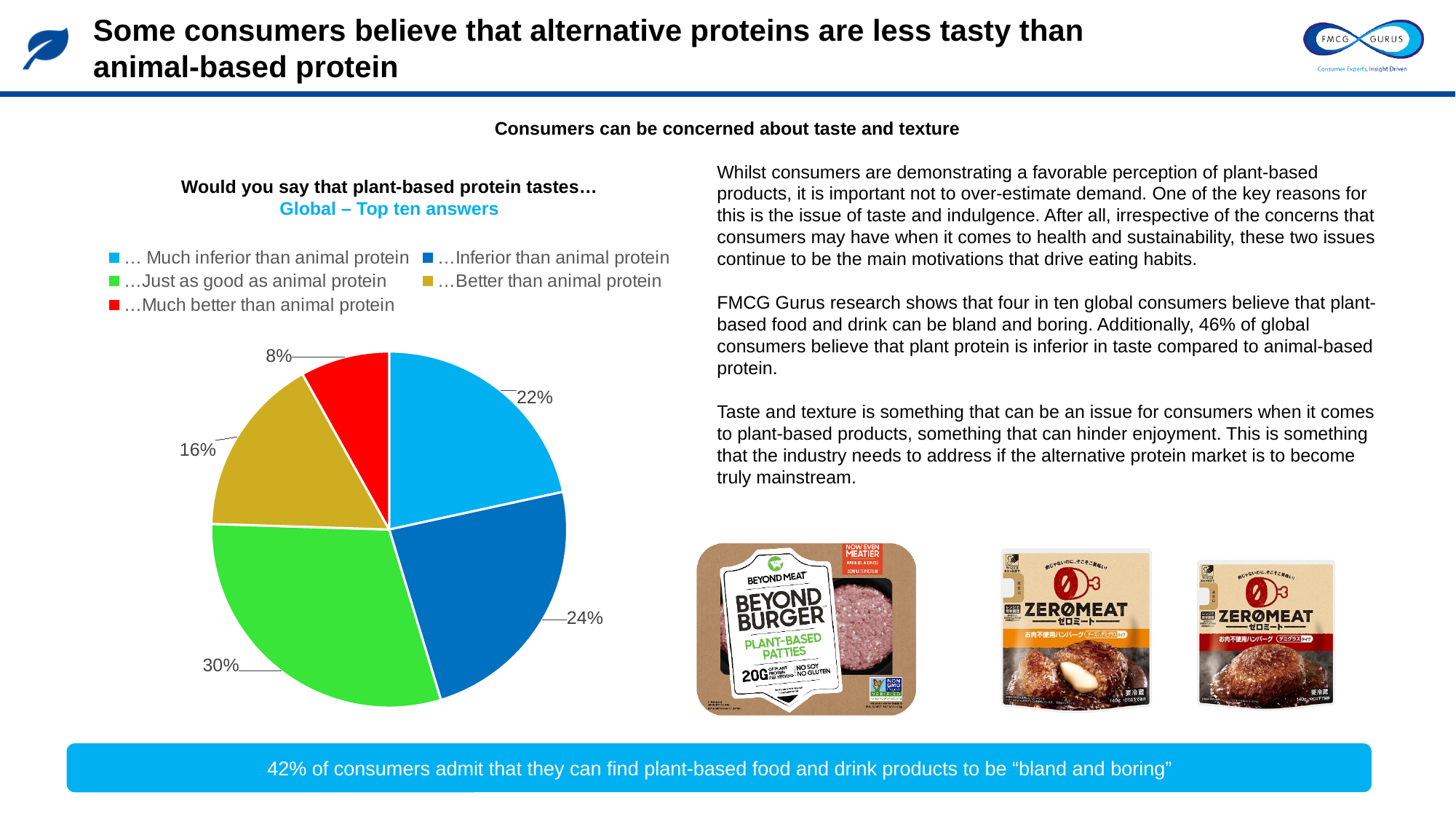
How many slices does the pie chart have? 5 What colour is the slice for '…Much better than animal protein'? Red What share of the pie is for '…Much better than animal protein'? 8% What is the difference between the shares for '…Just as good as animal protein' and '…Much better than animal protein'? 22% What kind of chart is shown on the slide? Pie chart What share of the pie is for '… Much inferior than animal protein'? 22% What share of the pie is for '…Just as good as animal protein'? 30% Which answer has the smallest slice of the pie? …Much better than animal protein Which is larger: the share for '…Inferior than animal protein' or '…Better than animal protein'? …Inferior than animal protein Which answer has the largest slice of the pie? …Just as good as animal protein